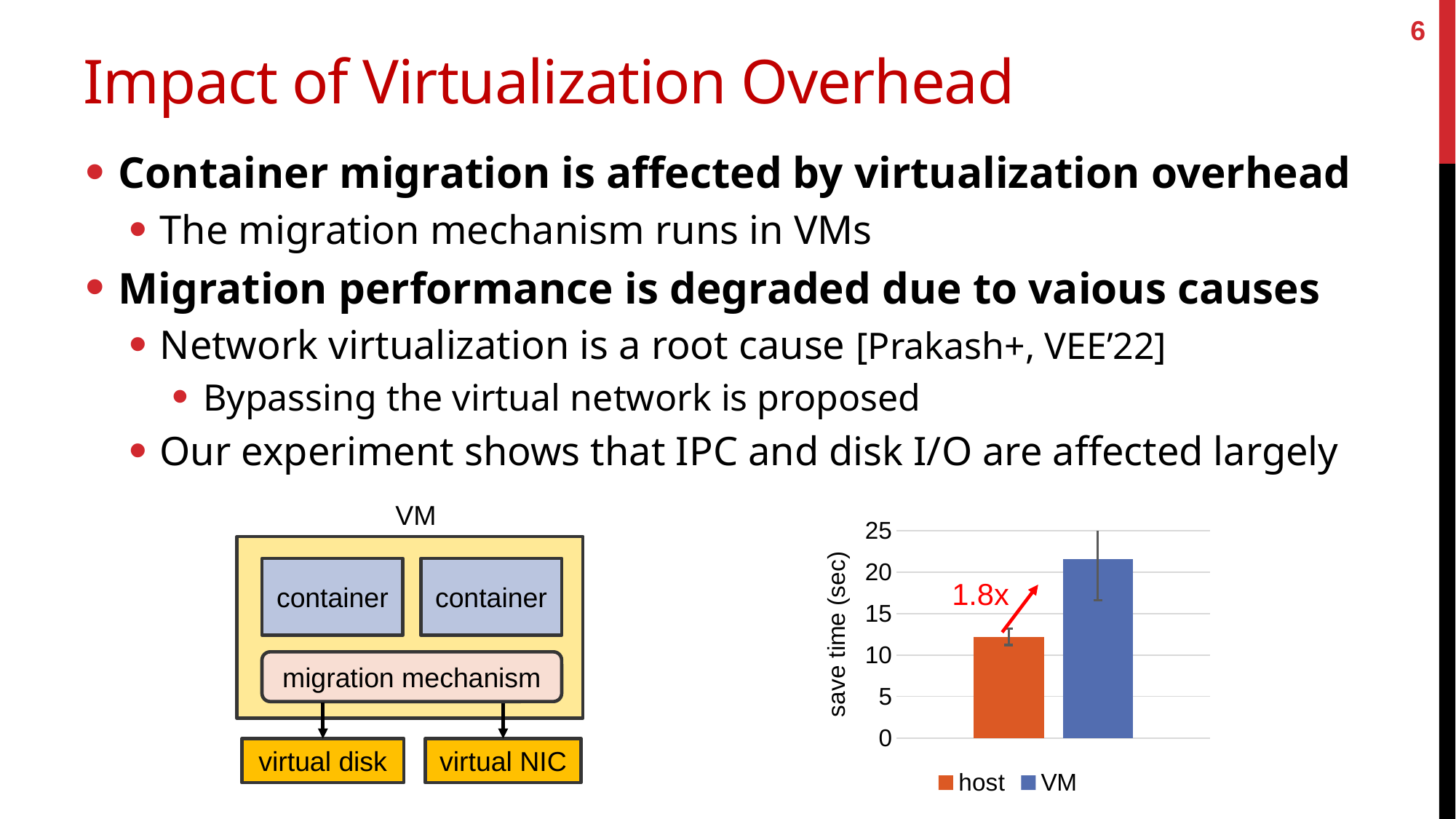
Which series has the higher save time, host or VM? VM Is the save time for VM greater or less than 15 seconds? greater How many series does the chart's legend list? 2 Which series has the lowest save time in the chart? host Is the save time for VM greater or less than 25 seconds? less Is the save time for host greater or less than 15 seconds? less What ratio is annotated in red next to the arrow between the two bars? 1.8x How many bars are plotted in the chart? 2 What kind of chart is shown on the slide? bar chart Which series has the highest save time in the chart? VM What is the label of the chart's vertical axis? save time (sec)